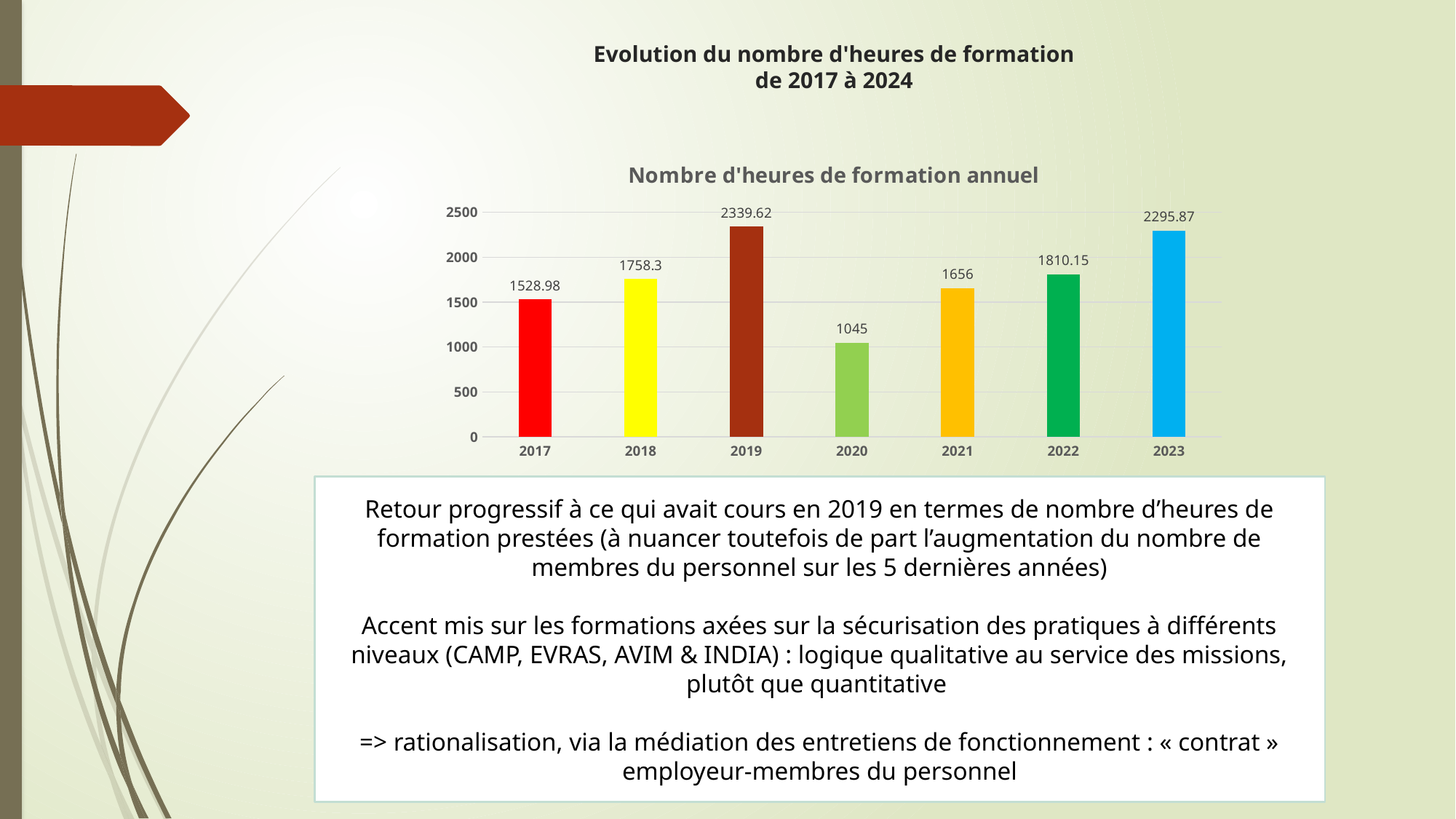
Is the value for 2021 greater or less than 2000? less Which year has the highest number of training hours? 2019 How many years are shown on the x axis of the chart? 7 Which is larger, the value for 2018 or the value for 2021? 2018 What kind of chart is shown on the slide? bar chart What is the value for 2022 in the chart? 1810.15 Which year has the lowest number of training hours? 2020 What is the title of the chart? Nombre d'heures de formation annuel What is the value for 2019 in the chart? 2339.62 What is the difference between the values for 2019 and 2020? 1294.62 What is the difference between the values for 2019 and 2023? 43.75 What is the value for 2020 in the chart? 1045